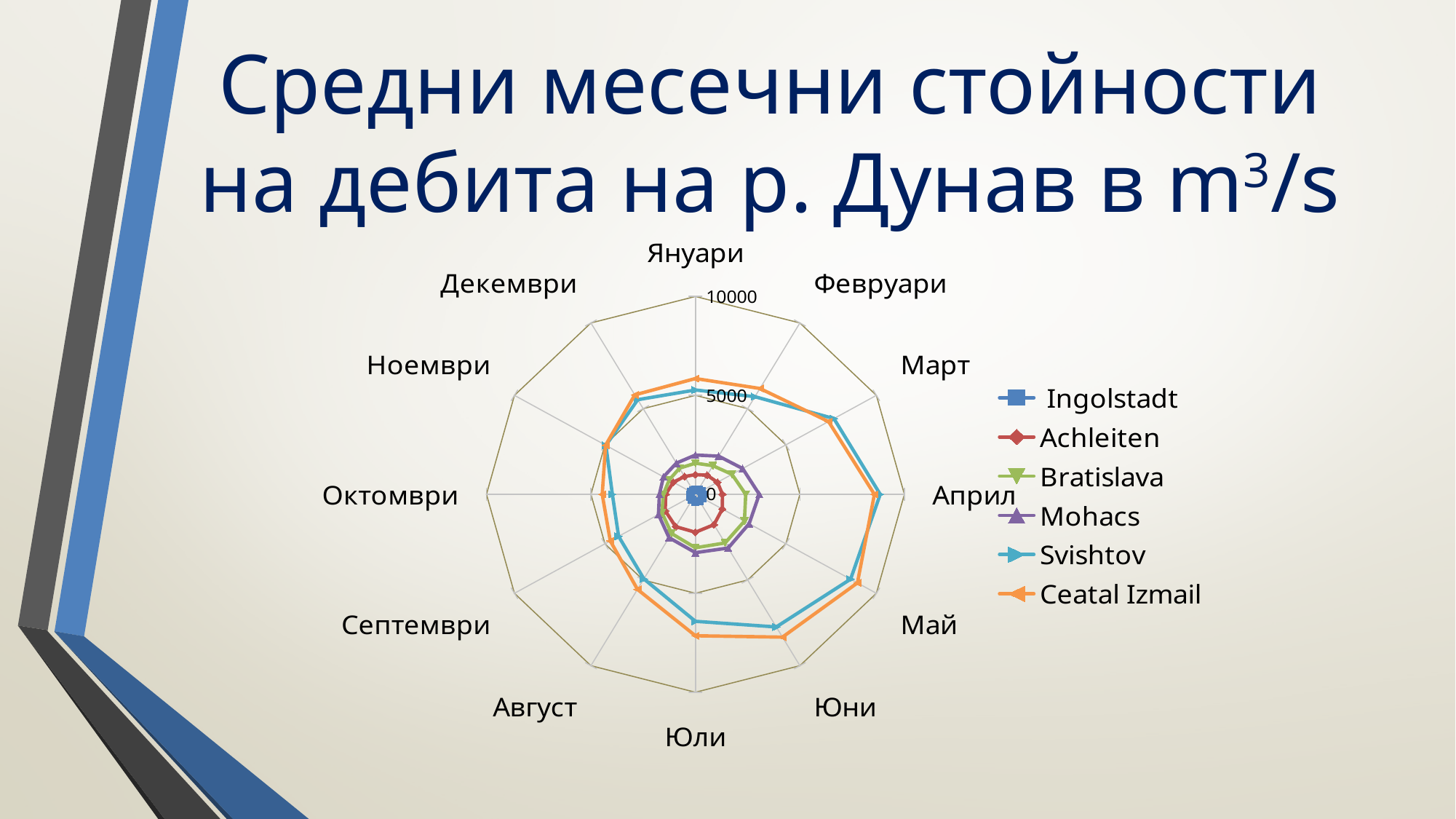
In Април, which is larger: the value for Ceatal Izmail or the value for Ingolstadt? Ceatal Izmail What kind of chart is shown on the slide? Radar chart Which series is shown in orange in the legend? Ceatal Izmail Is the value for Mohacs in Април greater or less than 5000? less How many series does the legend list? 6 How many categories (months) are plotted around the chart? 12 What is the title of the slide? Средни месечни стойности на дебита на р. Дунав в m³/s In Април, which is larger: the value for Mohacs or the value for Achleiten? Mohacs Is the value for Ingolstadt in Януари greater or less than 5000? less Is the value for Svishtov in Май greater or less than 5000? greater Which series has the lowest values across all months? Ingolstadt